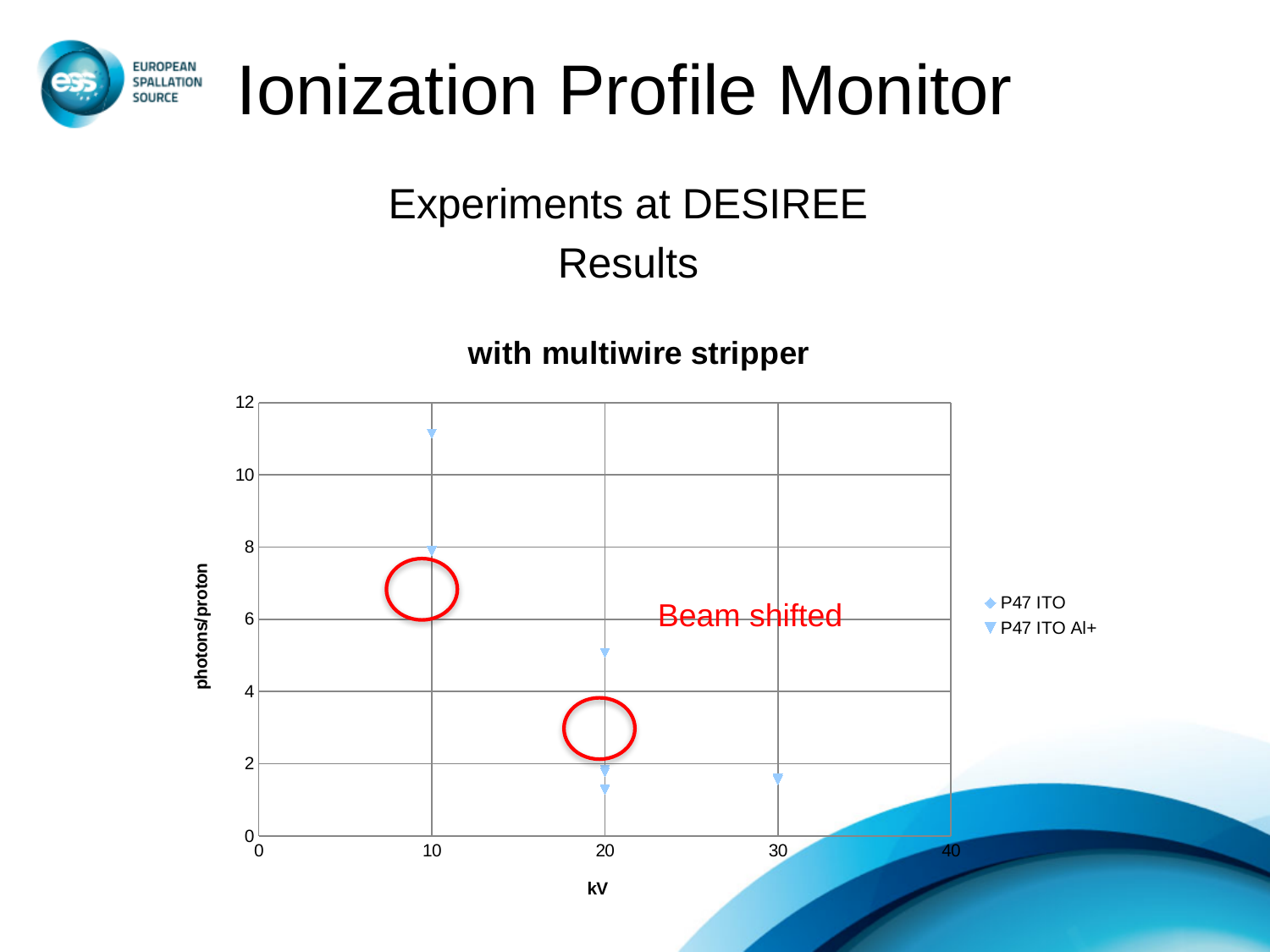
Is the highest plotted value at 10 kV greater or less than 10 photons/proton? greater Is the plotted value at 30 kV greater or less than 2 photons/proton? less Which has the larger photons/proton value: the highest point at 10 kV or the point at 30 kV? the highest point at 10 kV Is the lowest plotted value at 20 kV greater or less than 2 photons/proton? less How many data points are plotted in the "with multiwire stripper" chart? 6 What are the two series names in the legend of the "with multiwire stripper" chart? P47 ITO and P47 ITO Al+ At which kV value does the chart show its highest photons/proton reading? 10 Do the photons/proton values generally rise or fall as kV increases from 10 to 30? fall What is the label of the y axis in the "with multiwire stripper" chart? photons/proton What kind of chart is shown under the title "with multiwire stripper"? scatter chart How many series does the legend of the "with multiwire stripper" chart list? 2